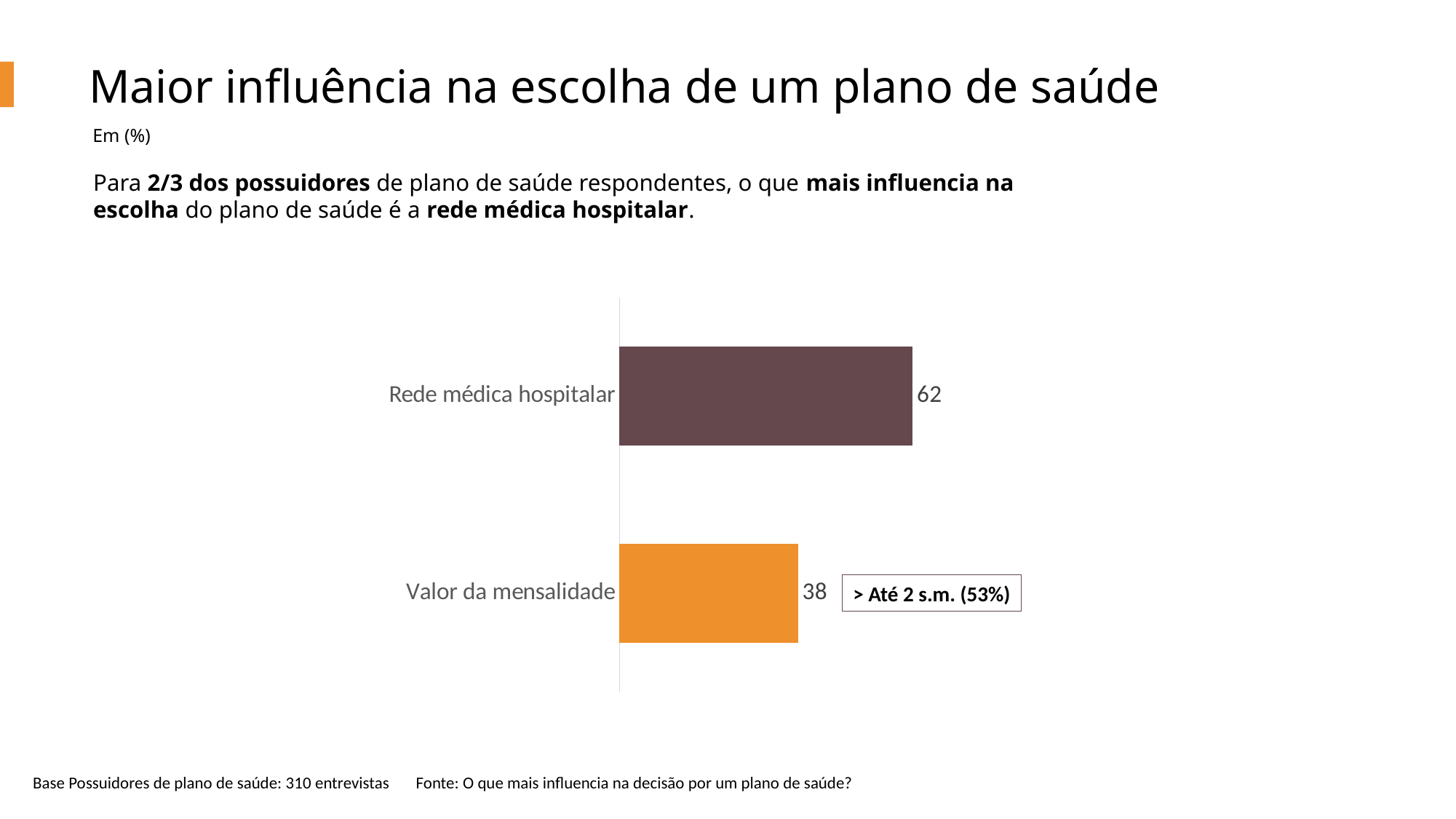
What does the callout box next to the Valor da mensalidade bar say? > Até 2 s.m. (53%) What is the title of the slide containing the chart? Maior influência na escolha de um plano de saúde What kind of chart is shown on the slide? Bar chart What is the value for Valor da mensalidade? 38 Which category has the highest value? Rede médica hospitalar Which is larger, the value for Rede médica hospitalar or the value for Valor da mensalidade? Rede médica hospitalar What is the difference between the values for Rede médica hospitalar and Valor da mensalidade? 24 What is the total of the two values shown in the chart? 100 What is the value for Rede médica hospitalar? 62 How many categories are shown in the chart? 2 What colour is the bar for Valor da mensalidade? Orange Which category has the lowest value? Valor da mensalidade